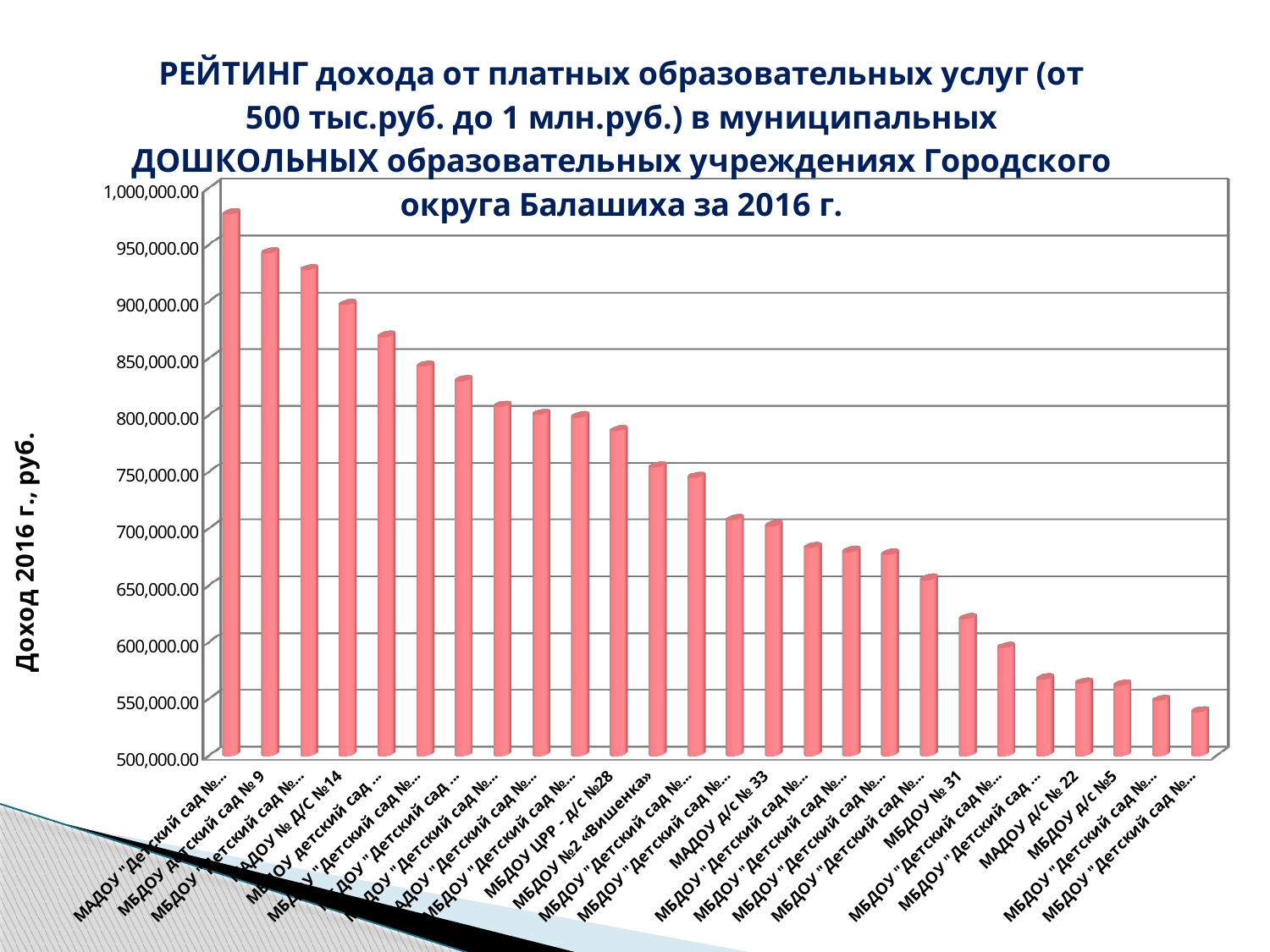
Do the values rise or fall from left to right along the x axis? fall Is the value for МБДОУ ЦРР - д/с №28 greater or less than 800,000.00? less What kind of chart is shown on the slide? bar chart Is the value for МБДОУ № 31 greater or less than 600,000.00? greater What is the title of the vertical axis? Доход 2016 г., руб. Is the value for МБДОУ детский сад № 9 greater or less than 900,000.00? greater Which has the larger value, МБДОУ № 31 or МАДОУ д/с № 22? МБДОУ № 31 Which has the larger value, МБДОУ детский сад № 9 or МАДОУ № Д/С №14? МБДОУ детский сад № 9 How many bars (institutions) are plotted in the chart? 26